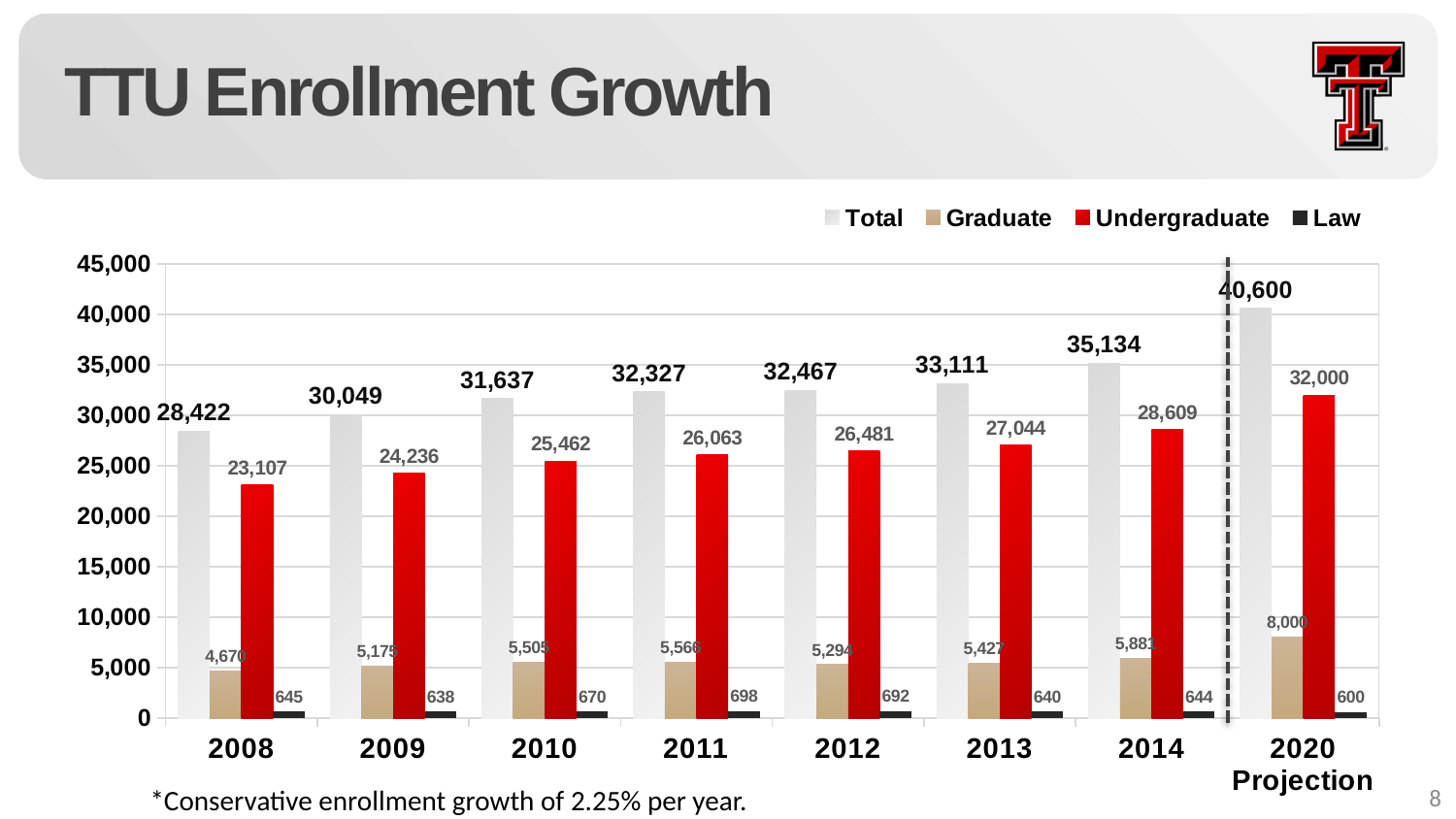
In which year is the Law enrollment highest? 2011 Does the Total enrollment rise or fall from 2008 to the 2020 Projection? rise What is the Total enrollment value for 2014? 35,134 Which year has the larger Undergraduate enrollment, 2012 or 2013? 2013 Is the Total value for the 2020 Projection greater or less than 40,000? greater How many series does the legend list? 4 Which category has the lowest Law enrollment? 2020 Projection What is the Graduate enrollment value for the 2020 Projection? 8,000 How many categories are shown on the x axis? 8 What is the Undergraduate enrollment value for 2011? 26,063 What is the Law enrollment value for 2010? 670 What is the difference between the Total enrollment in 2014 and in 2008? 6,712